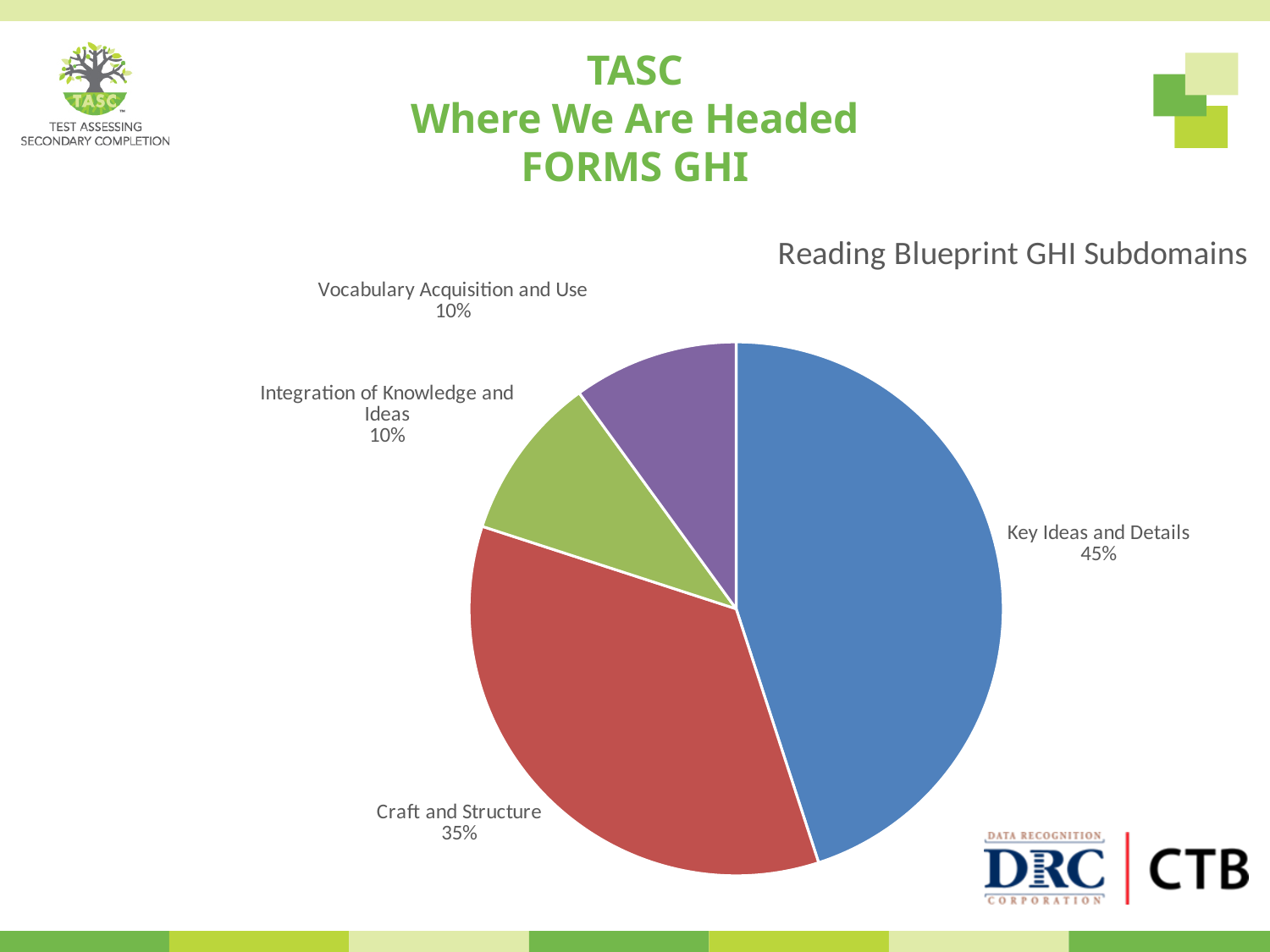
What is the value shown for Craft and Structure? 35% What type of chart is shown on the slide? Pie chart What percentage is shown for Integration of Knowledge and Ideas? 10% How many slices does the pie chart have? 4 What percentage is shown for Vocabulary Acquisition and Use? 10% What share of the pie does Key Ideas and Details represent? 45% What is the combined percentage of Vocabulary Acquisition and Use and Integration of Knowledge and Ideas? 20% What is the title of the chart? Reading Blueprint GHI Subdomains What is the difference in percentage points between Key Ideas and Details and Craft and Structure? 10 Which subdomain has the largest slice of the pie? Key Ideas and Details What colour is the Key Ideas and Details slice? Blue Which is larger, Craft and Structure or Integration of Knowledge and Ideas? Craft and Structure